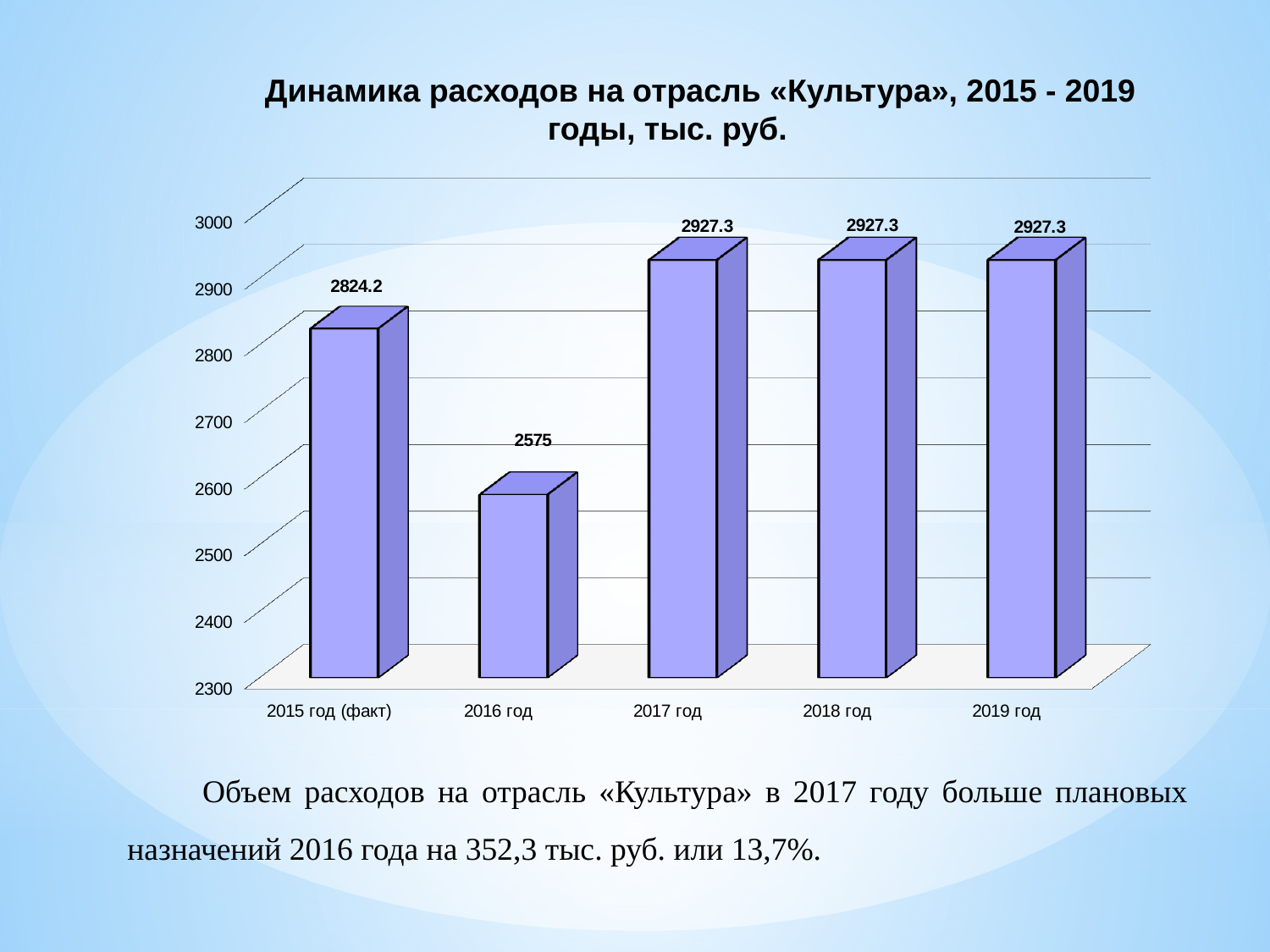
What is the title of the chart? Динамика расходов на отрасль «Культура», 2015 - 2019 годы, тыс. руб. What is the difference between the values for 2017 год and 2016 год? 352.3 Is the value for 2019 год greater or less than 2900? greater Is the value for 2016 год greater or less than 2600? less What is the value for 2015 год (факт)? 2824.2 What is the difference between the values for 2015 год (факт) and 2016 год? 249.2 What is the value for 2018 год? 2927.3 Which category has the lowest value? 2016 год Which is larger, the value for 2015 год (факт) or the value for 2017 год? 2017 год How many categories are shown on the x axis? 5 What is the value for 2016 год? 2575 What kind of chart is shown on the slide? bar chart